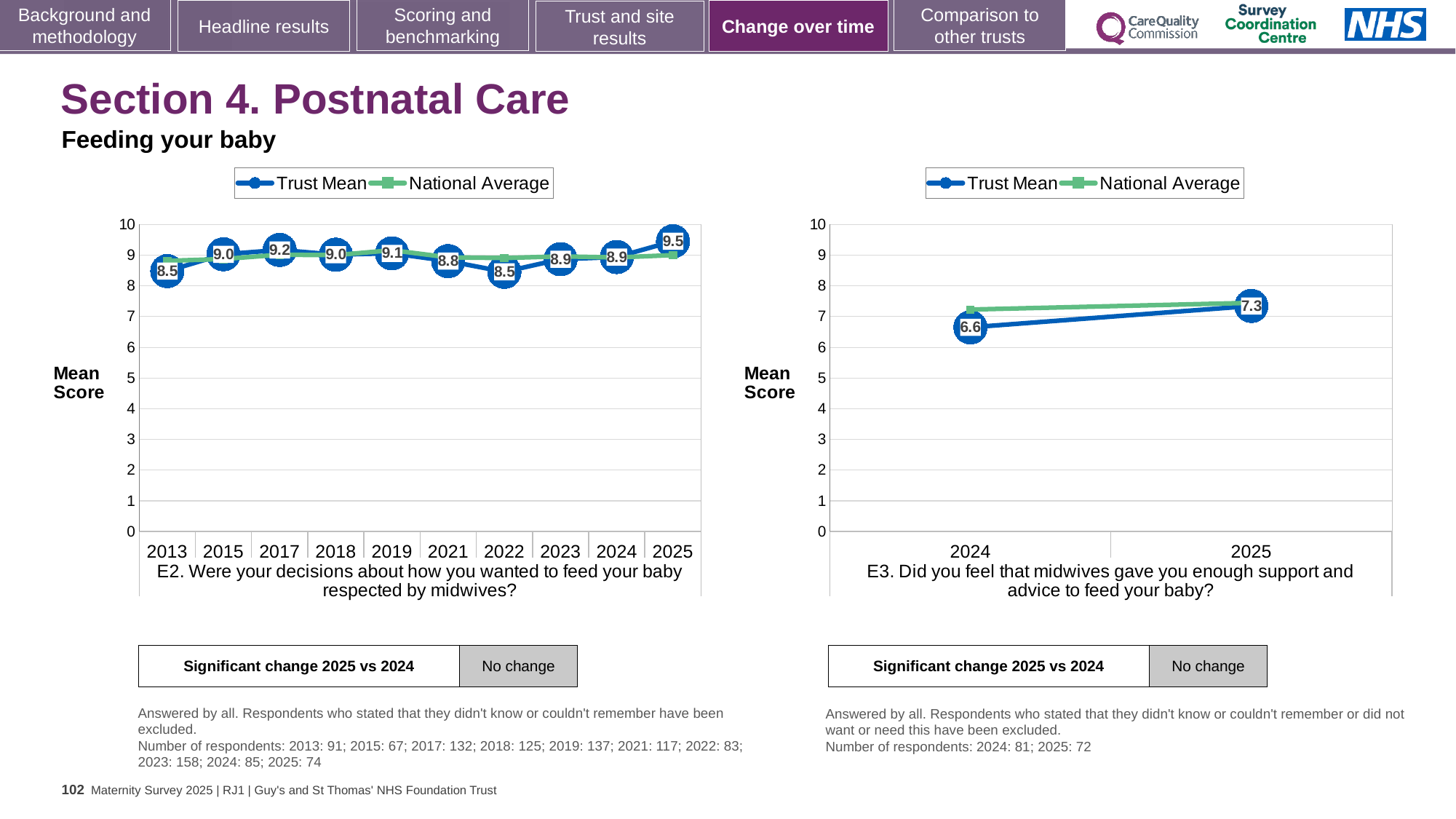
In the E3 chart (right), does the Trust Mean rise or fall from 2024 to 2025? rise In the E2 chart (left), which year has the highest Trust Mean? 2025 In the E2 chart (left), how many years are plotted on the x axis? 10 What kind of chart is the E2 chart (left)? line chart In the E2 chart (left), what is the Trust Mean for 2013? 8.5 How many series does the legend of the E3 chart (right) list? 2 In the E3 chart (right), what is the Trust Mean for 2025? 7.3 In the E2 chart (left), what is the Trust Mean for 2025? 9.5 In the E2 chart (left), is the Trust Mean higher in 2017 or in 2022? 2017 In the E2 chart (left), what is the difference between the Trust Mean in 2025 and in 2024? 0.6 In the E3 chart (right), is the National Average for 2024 greater or less than 7? greater In the E3 chart (right), what is the Trust Mean for 2024? 6.6